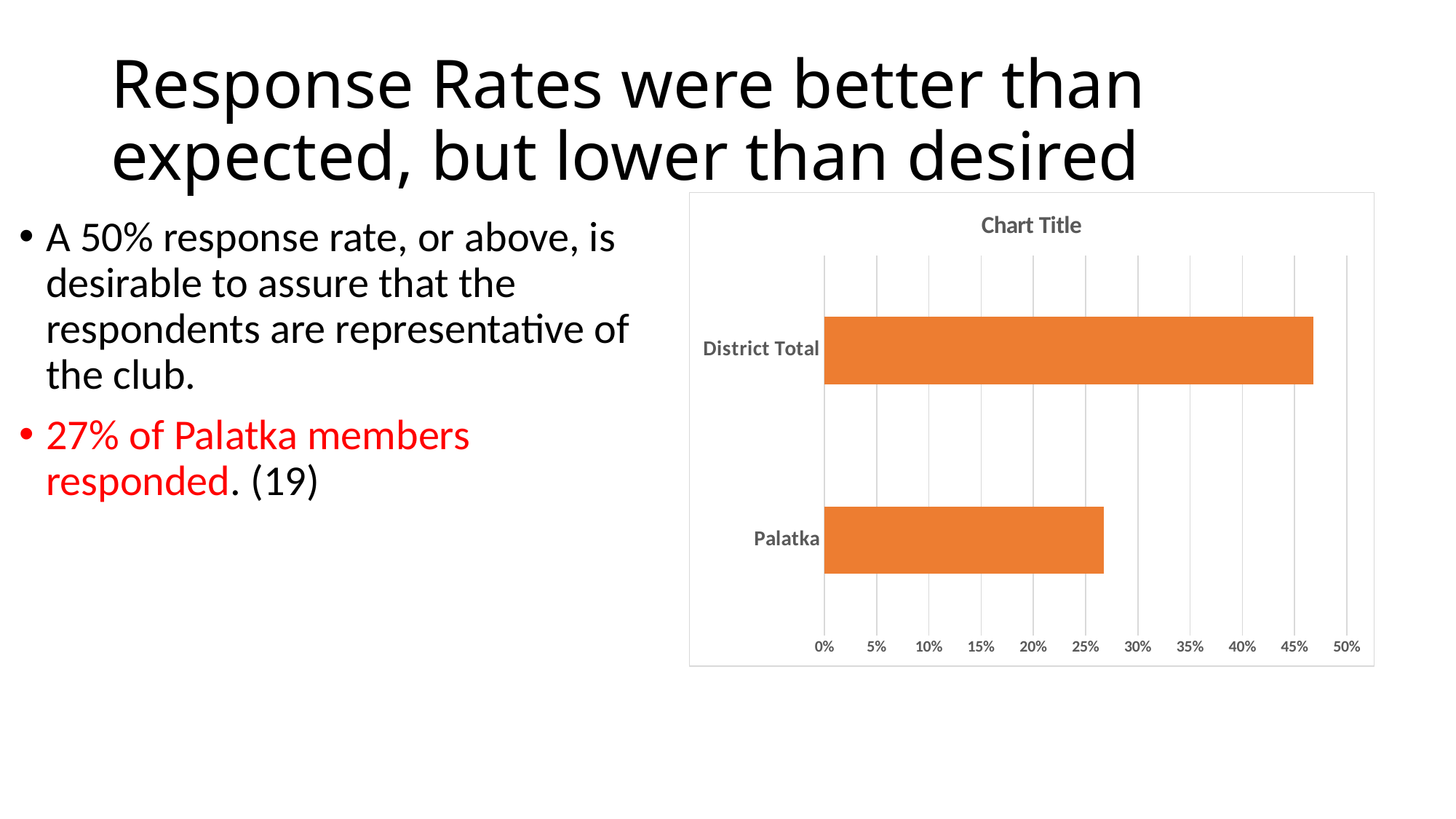
Is the value for District Total greater or less than 50%? less Which category has the lowest value in the chart? Palatka Is the value for Palatka greater or less than 30%? less Is the value for District Total greater or less than 45%? greater Which category has the highest value in the chart? District Total Which is larger, the value for District Total or the value for Palatka? District Total What is the title shown above the chart? Chart Title What colour are the bars in the chart? orange What is the highest value shown on the chart's horizontal axis? 50% How many categories are plotted in the chart? 2 What kind of chart is shown on the slide? bar chart